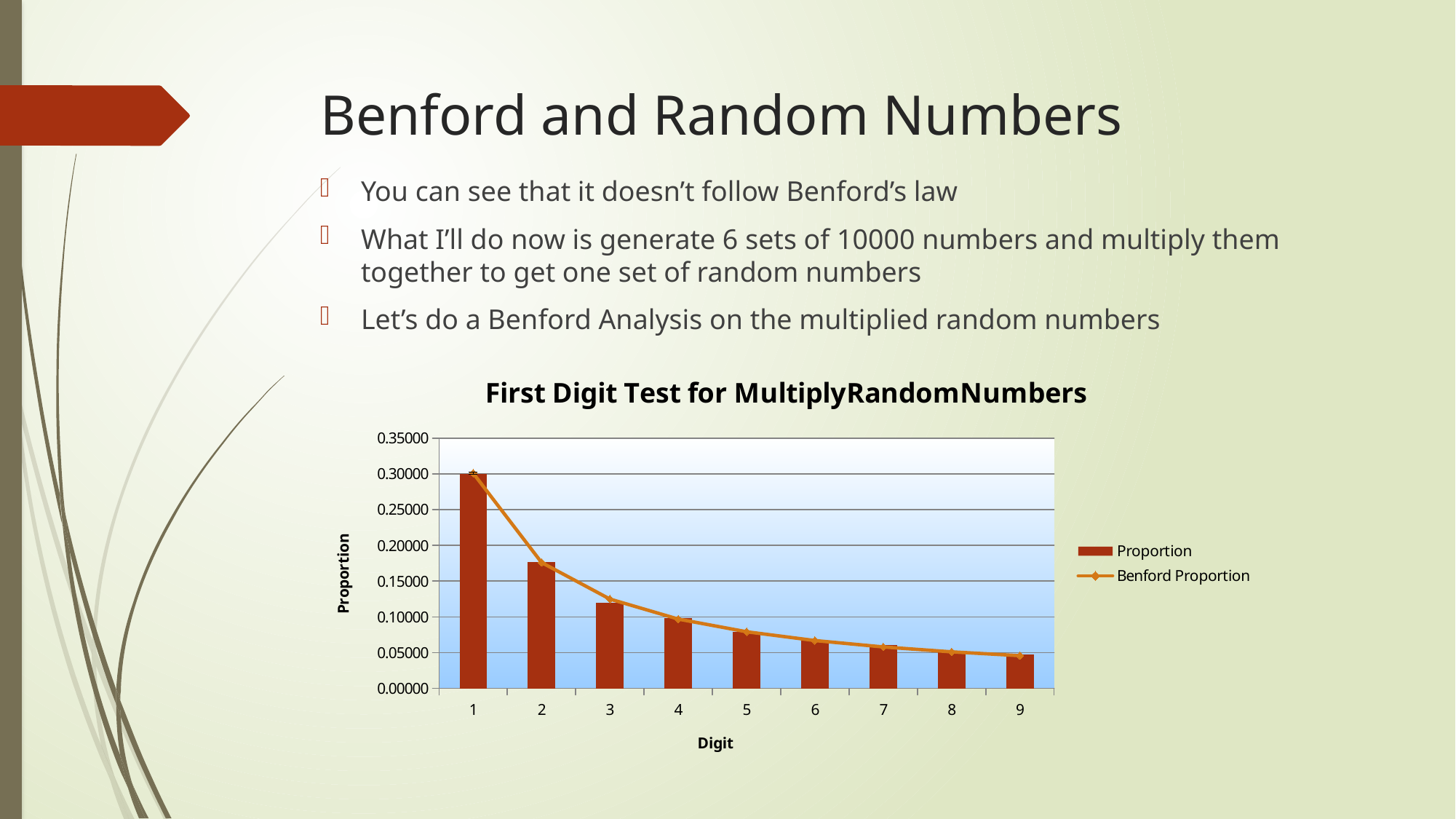
Which has the larger Proportion bar, digit 2 or digit 3? digit 2 Is the Proportion value for digit 1 greater or less than 0.25000? greater Is the Proportion value for digit 2 greater or less than 0.15000? greater How many digits are shown on the x axis of the chart? 9 Is the Proportion value for digit 5 greater or less than 0.10000? less Which digit has the highest Proportion bar? 1 Do the Proportion bars rise or fall as the digit increases from 1 to 9? fall What is the label of the y axis of the chart? Proportion What is the title of the chart? First Digit Test for MultiplyRandomNumbers Which digit has the lowest Proportion bar? 9 How many series does the chart's legend list? 2 What kind of chart is shown on the slide? bar chart with a line